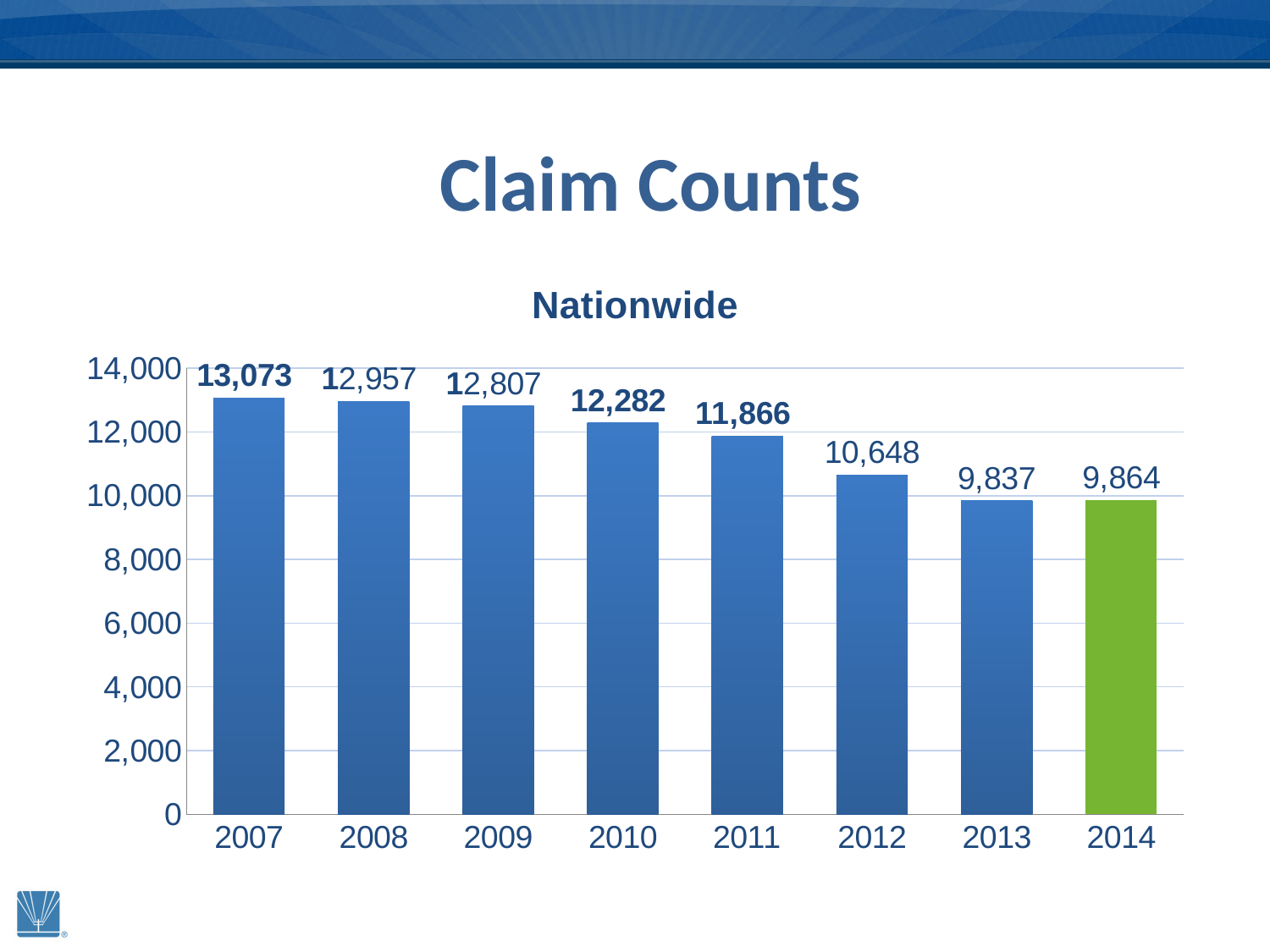
What is the difference between the claim counts for 2011 and 2012? 1,218 What is the claim count for 2012? 10,648 Which year has the highest claim count? 2007 Which bar is shown in a different colour (green) from the others? 2014 What kind of chart is shown on the slide? bar chart Which year has the lowest claim count? 2013 Which year has a larger claim count, 2010 or 2012? 2010 What is the claim count for 2007? 13,073 How many years are shown on the chart? 8 Is the value for 2011 greater or less than 10,000? greater What is the difference between the claim counts for 2007 and 2014? 3,209 What is the claim count for 2014? 9,864